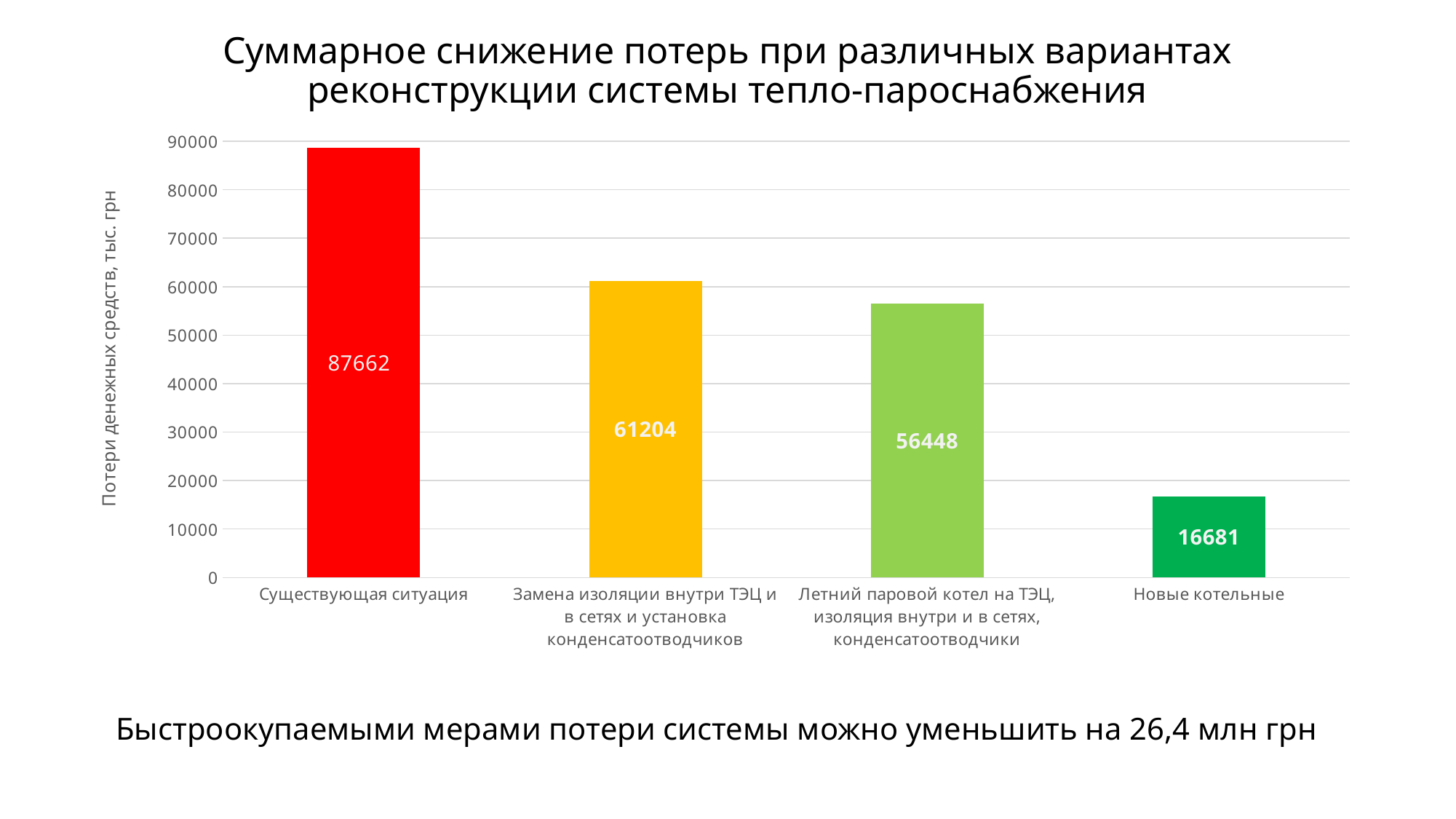
What is the value for «Замена изоляции внутри ТЭЦ и в сетях и установка конденсатоотводчиков»? 61204 What kind of chart is shown on the slide? Bar chart How many categories are shown on the chart? 4 What is the value for «Существующая ситуация»? 87662 What is the label of the vertical axis? Потери денежных средств, тыс. грн Which category has the highest value? Существующая ситуация What is the value for «Новые котельные»? 16681 What is the difference between «Замена изоляции внутри ТЭЦ и в сетях и установка конденсатоотводчиков» and «Летний паровой котел на ТЭЦ, изоляция внутри и в сетях, конденсатоотводчики»? 4756 What is the difference between «Существующая ситуация» and «Новые котельные»? 70981 Which category has the lowest value? Новые котельные What is the value for «Летний паровой котел на ТЭЦ, изоляция внутри и в сетях, конденсатоотводчики»? 56448 Which is larger: the value for «Замена изоляции внутри ТЭЦ и в сетях и установка конденсатоотводчиков» or for «Летний паровой котел на ТЭЦ, изоляция внутри и в сетях, конденсатоотводчики»? Замена изоляции внутри ТЭЦ и в сетях и установка конденсатоотводчиков